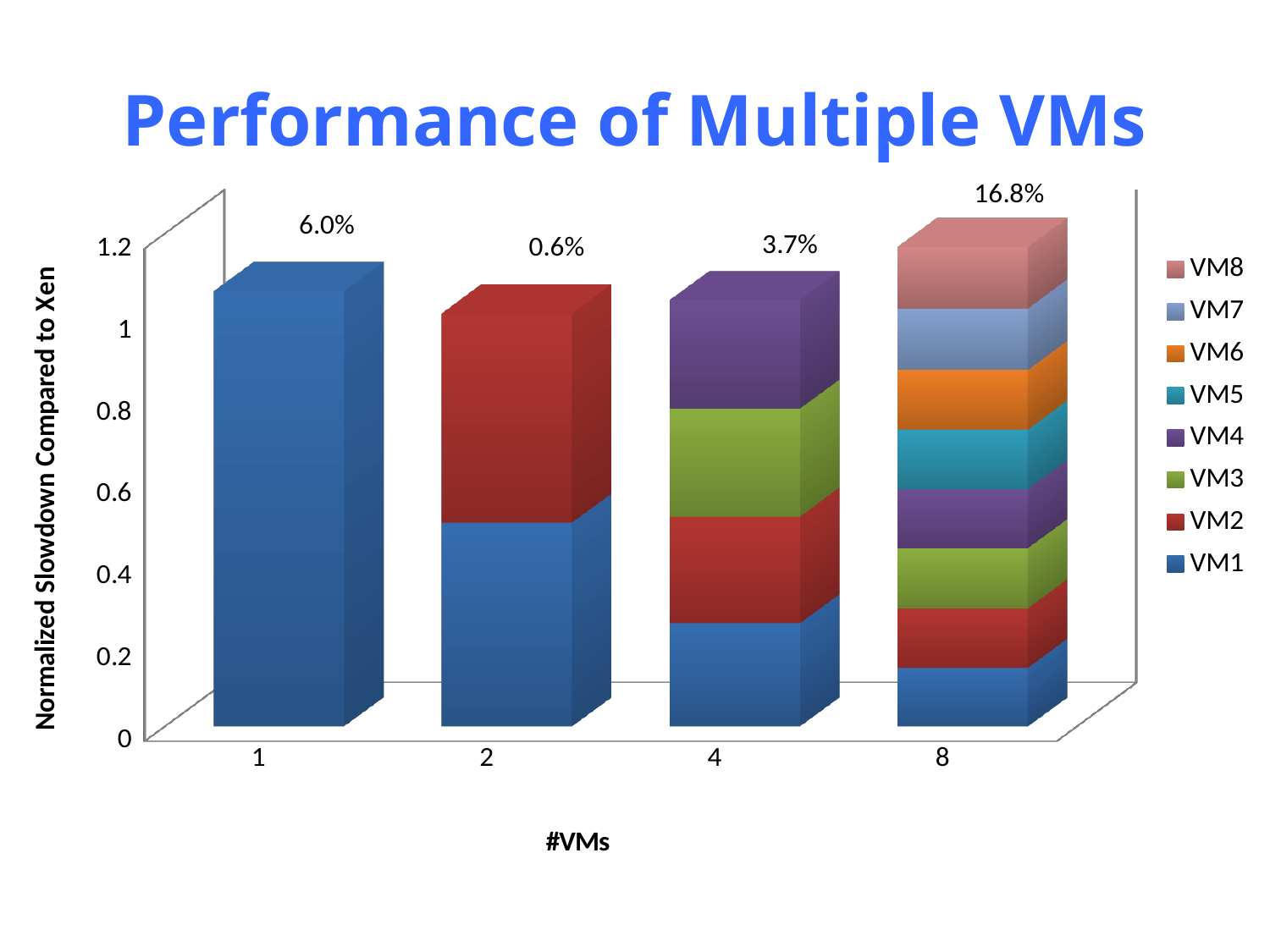
How many series does the legend list? 8 Is the total height of the bar for 2 VMs greater or less than 0.8? greater What kind of chart is shown on the slide? Stacked bar chart Which #VMs category has the highest percentage label above its bar? 8 What percentage label is shown above the bar for 2 VMs? 0.6% Which has the larger percentage label above its bar: 1 VM or 4 VMs? 1 VM How many #VMs categories are shown on the x axis? 4 What is the difference between the percentage labels for 8 VMs and 1 VM? 10.8 percentage points What percentage label is shown above the bar for 4 VMs? 3.7% What percentage label is shown above the bar for 8 VMs? 16.8% What percentage label is shown above the bar for 1 VM? 6.0% Which #VMs category has the lowest percentage label above its bar? 2